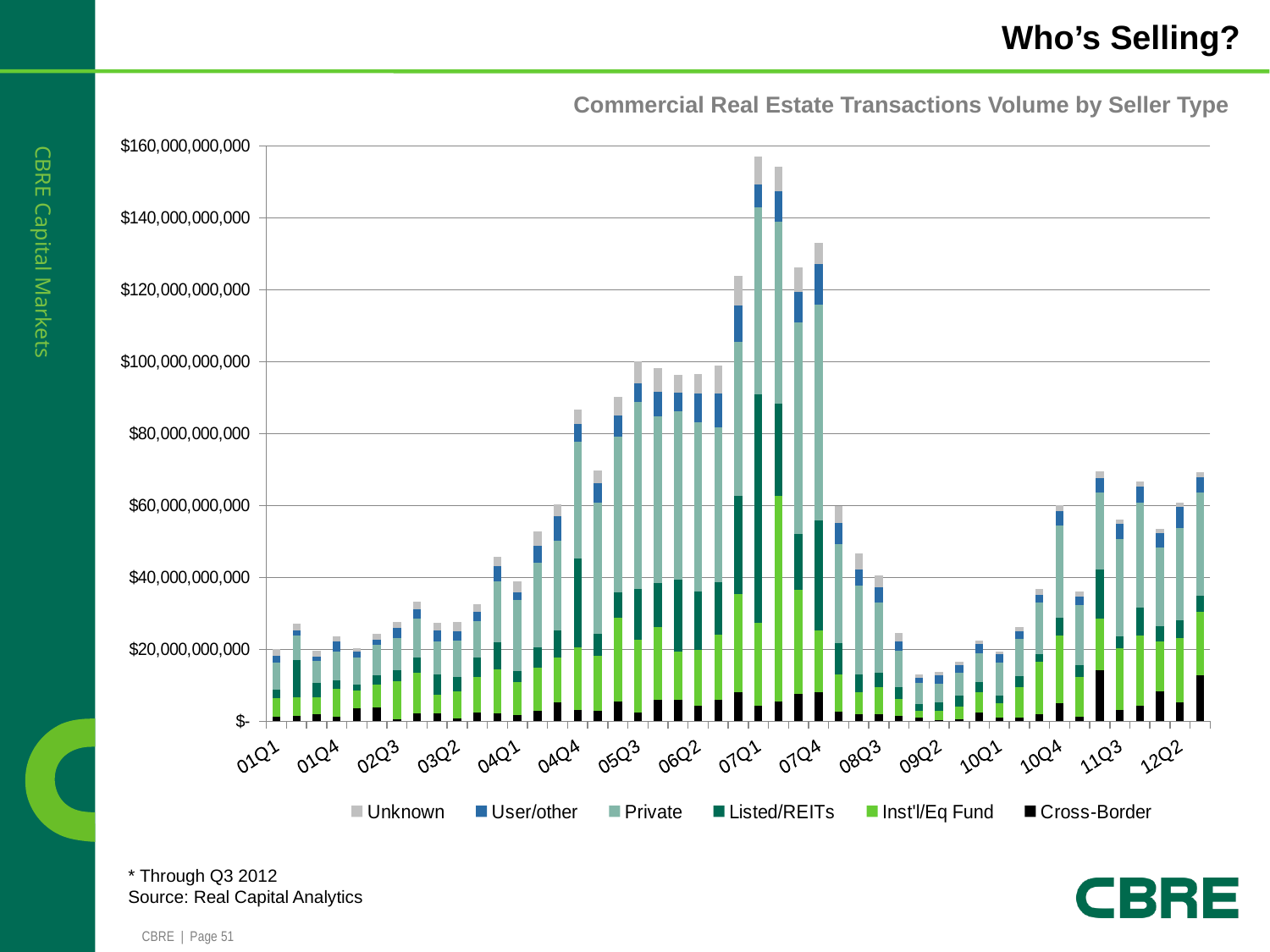
What kind of chart is shown on the slide? Stacked bar chart Which quarter has the larger total transaction volume, 12Q2 or 09Q2? 12Q2 Is the total transaction volume for 09Q2 greater or less than $20,000,000,000? less How many seller types does the legend list? 6 Is the total transaction volume for 05Q3 greater or less than $80,000,000,000? greater What is the title of the chart? Commercial Real Estate Transactions Volume by Seller Type Is the total transaction volume for 01Q1 greater or less than $40,000,000,000? less Which seller types are listed in the legend? Unknown, User/other, Private, Listed/REITs, Inst'l/Eq Fund, Cross-Border Do total transaction volumes rise or fall from 07Q4 to 09Q2? fall Which quarter has the larger total transaction volume, 07Q1 or 01Q1? 07Q1